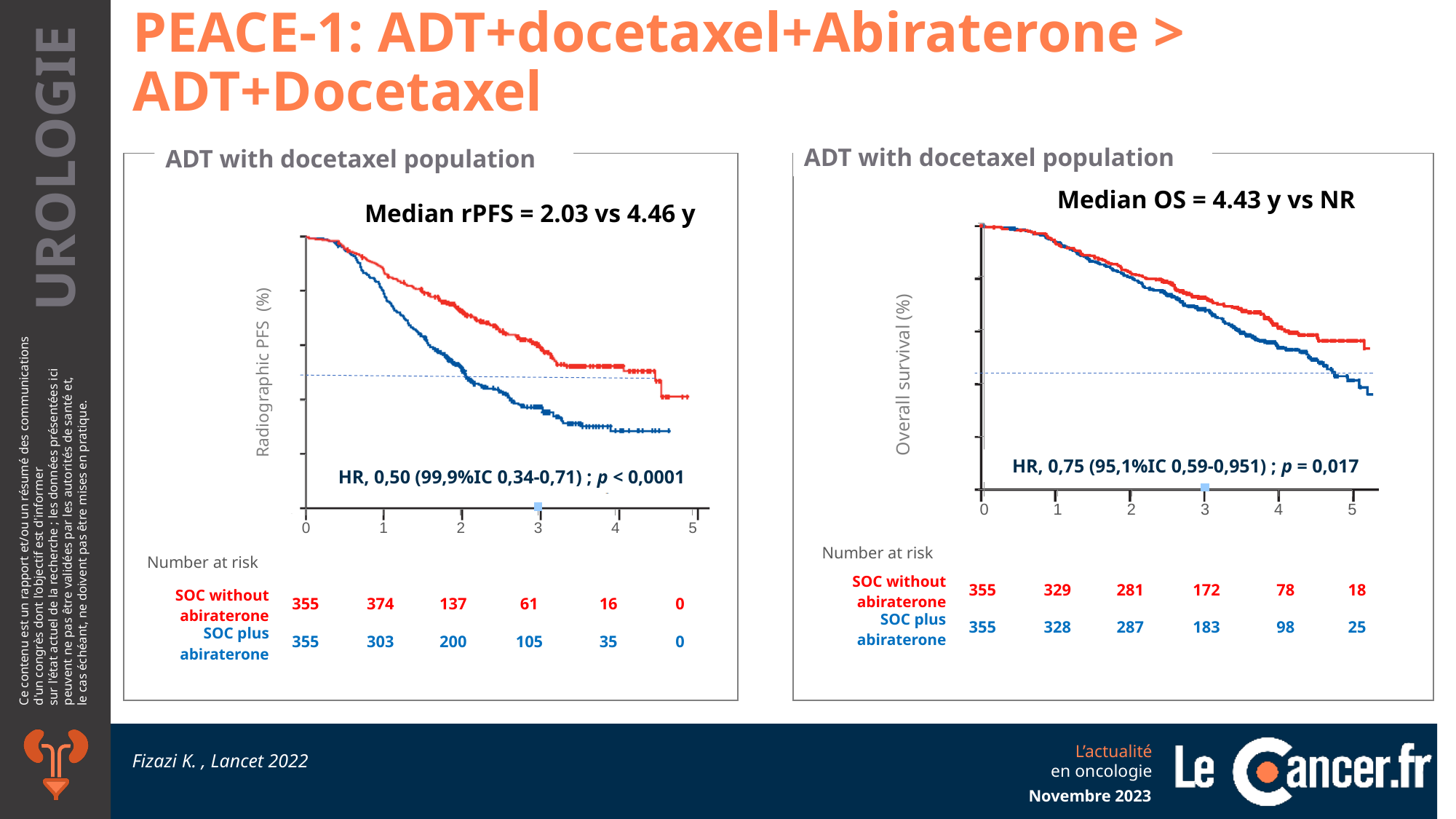
In the right chart (Overall survival), what is the p-value reported? p = 0,017 In the right chart (Overall survival), what is the number at risk for the SOC without abiraterone group at year 3? 172 What is the y-axis label of the right chart? Overall survival (%) What kind of chart is shown on the left of the slide? Line chart (Kaplan-Meier survival curve) In the right chart (Overall survival), what is the difference in number at risk at year 4 between the SOC plus abiraterone group and the SOC without abiraterone group? 20 In the left chart, what are the median rPFS values stated for the two groups? 2.03 vs 4.46 y In the left chart (Radiographic PFS), what hazard ratio is reported? 0,50 How many treatment groups are plotted in the left chart? 2 In the right chart (Overall survival), what is the number at risk for the SOC plus abiraterone group at year 5? 25 How many time points are listed in the number-at-risk table of the right chart? 6 In the left chart (Radiographic PFS), what is the number at risk for the SOC plus abiraterone group at year 2? 200 In the left chart (Radiographic PFS), which group has more patients at risk at year 1? SOC without abiraterone